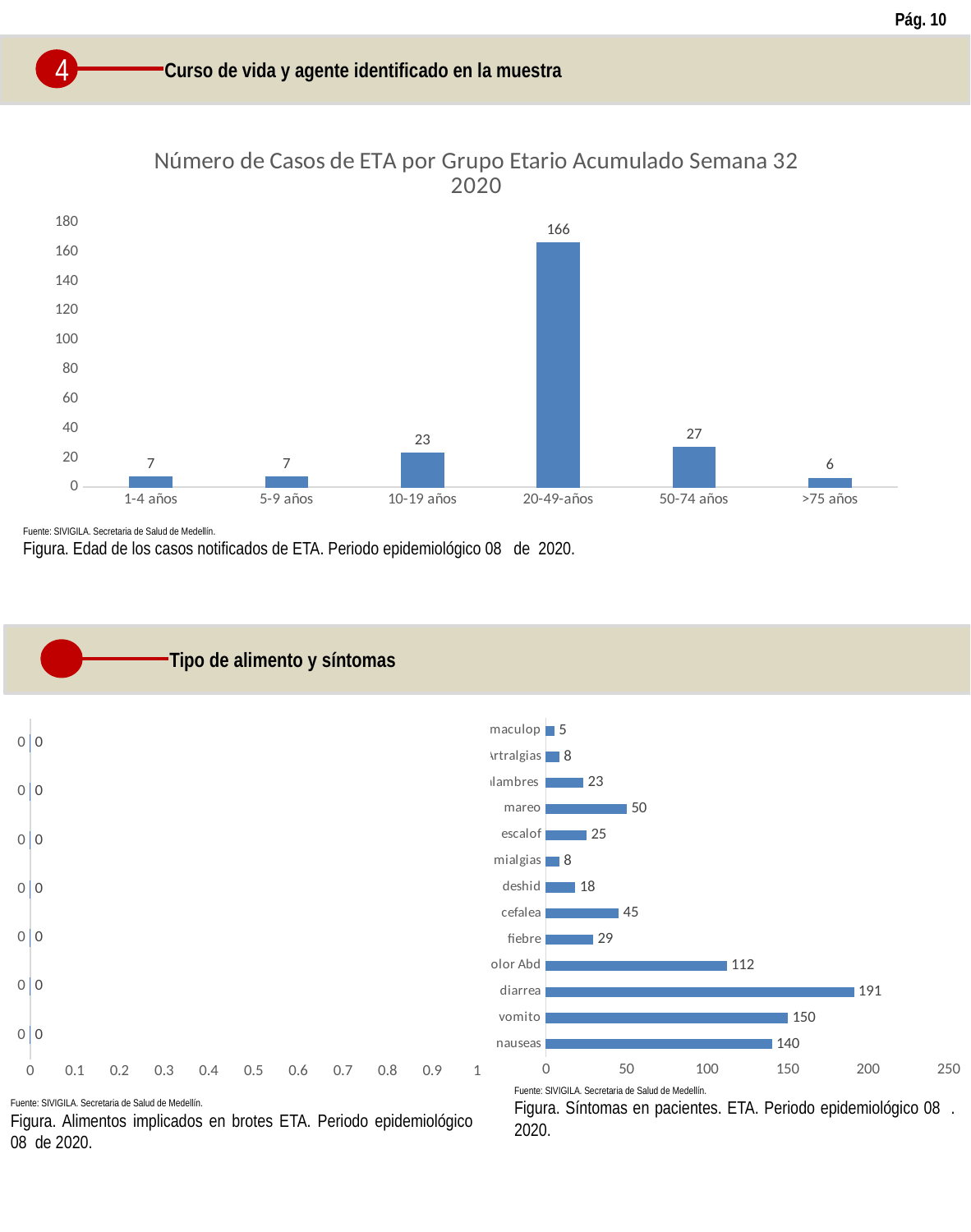
In the top chart 'Número de Casos de ETA por Grupo Etario', how many age groups are shown on the x axis? 6 In the top chart 'Número de Casos de ETA por Grupo Etario', what is the difference between the cases for 50-74 años and 10-19 años? 4 In the symptoms bar chart at the bottom right of the slide, which symptom has the highest value? diarrea What kind of chart is the top chart 'Número de Casos de ETA por Grupo Etario Acumulado Semana 32 2020'? bar chart In the symptoms bar chart at the bottom right of the slide, what is the value for diarrea? 191 In the symptoms bar chart at the bottom right of the slide, what is the difference between the values for mareo and fiebre? 21 In the top chart 'Número de Casos de ETA por Grupo Etario', which age group has the lowest number of cases? >75 años In the symptoms bar chart at the bottom right of the slide, what is the value for cefalea? 45 In the top chart 'Número de Casos de ETA por Grupo Etario Acumulado Semana 32 2020', how many cases are shown for the 20-49 años group? 166 In the top chart 'Número de Casos de ETA por Grupo Etario', is the value for 50-74 años greater or less than 20? greater In the top chart 'Número de Casos de ETA por Grupo Etario', which age group has the highest number of cases? 20-49-años In the symptoms bar chart at the bottom right of the slide, which is larger, the value for vomito or the value for nauseas? vomito